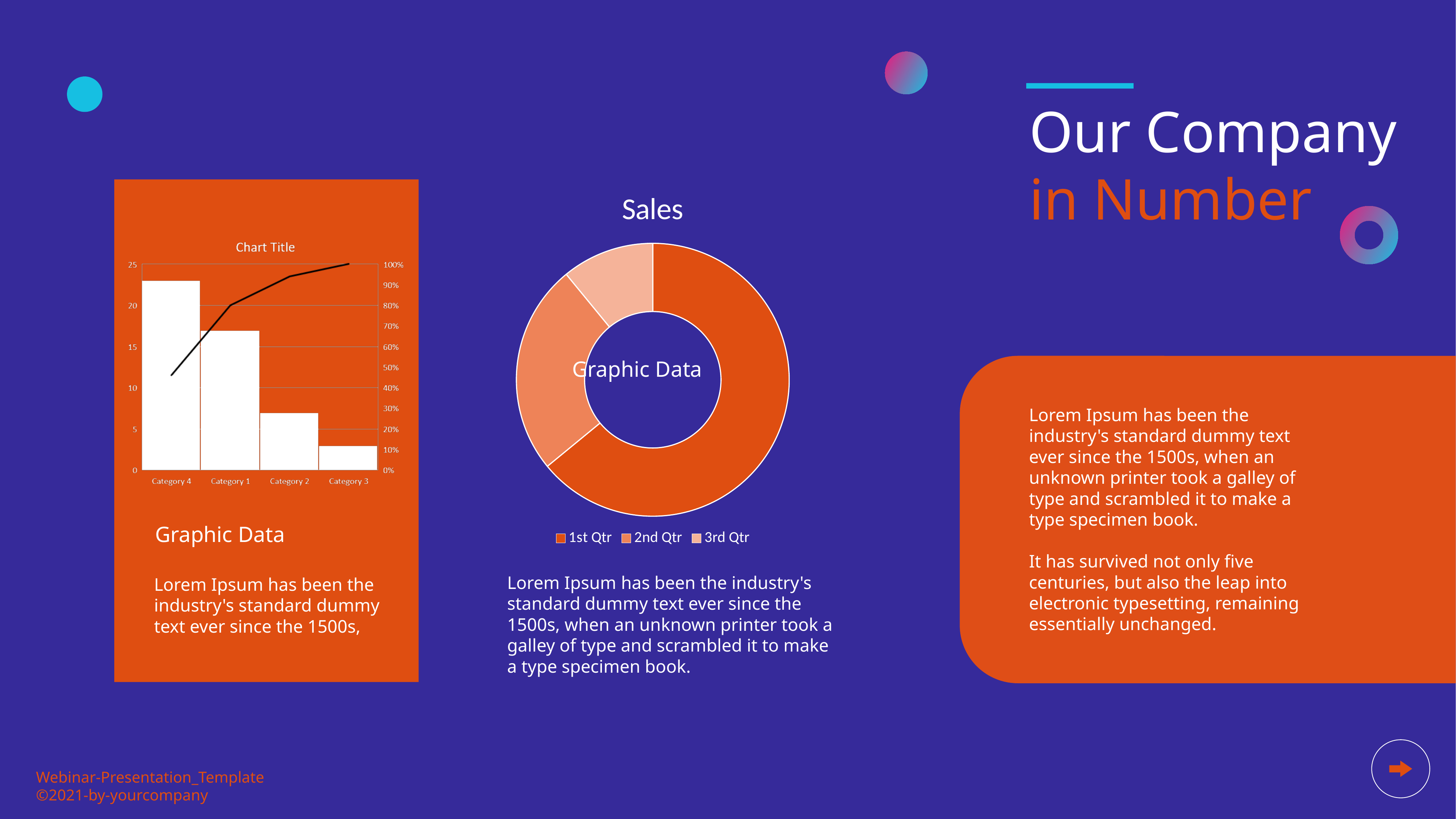
In the chart titled "Chart Title" on the left, is the bar for Category 3 greater or less than 5? less In the chart titled "Chart Title" on the left, is the bar for Category 2 greater or less than 10? less In the chart titled "Chart Title" on the left, how many categories are shown on the x axis? 4 In the chart titled "Chart Title" on the left, which category has the tallest bar? Category 4 In the "Sales" chart, which quarter has the largest slice? 1st Qtr What kind of chart is the "Sales" chart in the middle of the slide? doughnut chart In the chart titled "Chart Title" on the left, which bar is taller, Category 1 or Category 2? Category 1 In the chart titled "Chart Title" on the left, is the bar for Category 4 greater or less than 20? greater In the "Sales" chart, how many entries does the legend list? 3 In the chart titled "Chart Title" on the left, does the black line rise or fall from left to right? rise In the chart titled "Chart Title" on the left, do the bars rise or fall from left to right along the x axis? fall In the chart titled "Chart Title" on the left, which category has the shortest bar? Category 3